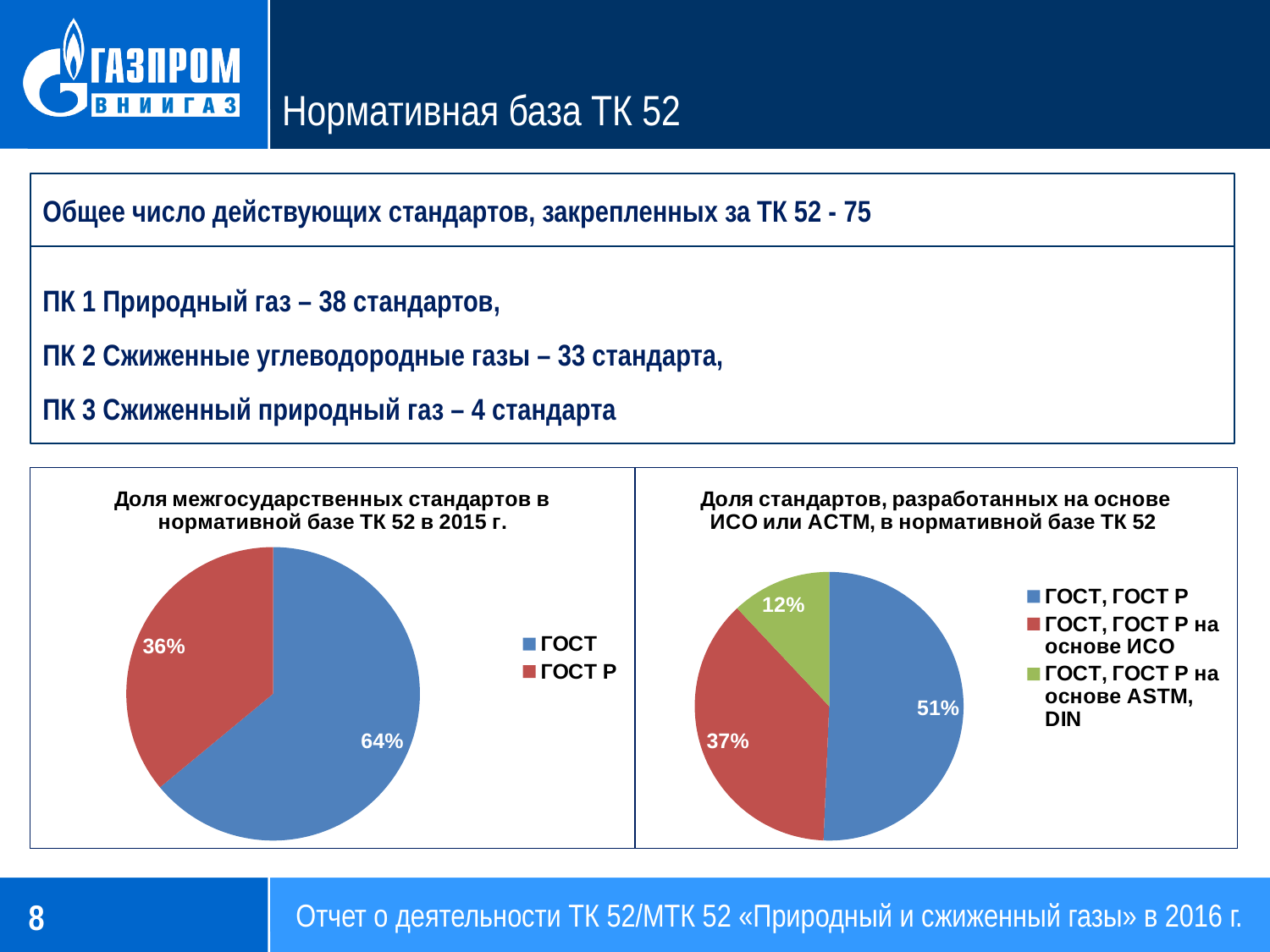
In the right pie chart, which category has the smallest share? ГОСТ, ГОСТ Р на основе ASTM, DIN In the right pie chart, is the share for ГОСТ, ГОСТ Р larger or smaller than the share for ГОСТ, ГОСТ Р на основе ИСО? larger What type of chart is used on the left side of the slide? pie chart How many categories does the legend of the right pie chart list? 3 In the right pie chart, what share is shown for ГОСТ, ГОСТ Р на основе ИСО? 37% How many slices does the left pie chart have? 2 In the left pie chart, what share is shown for ГОСТ Р? 36% In the left pie chart, which category has the larger share? ГОСТ In the left pie chart, what share is shown for ГОСТ? 64% In the right pie chart, what share is shown for ГОСТ, ГОСТ Р на основе ASTM, DIN? 12% In the left pie chart, what is the difference in percentage points between the ГОСТ and ГОСТ Р shares? 28 percentage points In the right pie chart, which category has the largest share? ГОСТ, ГОСТ Р